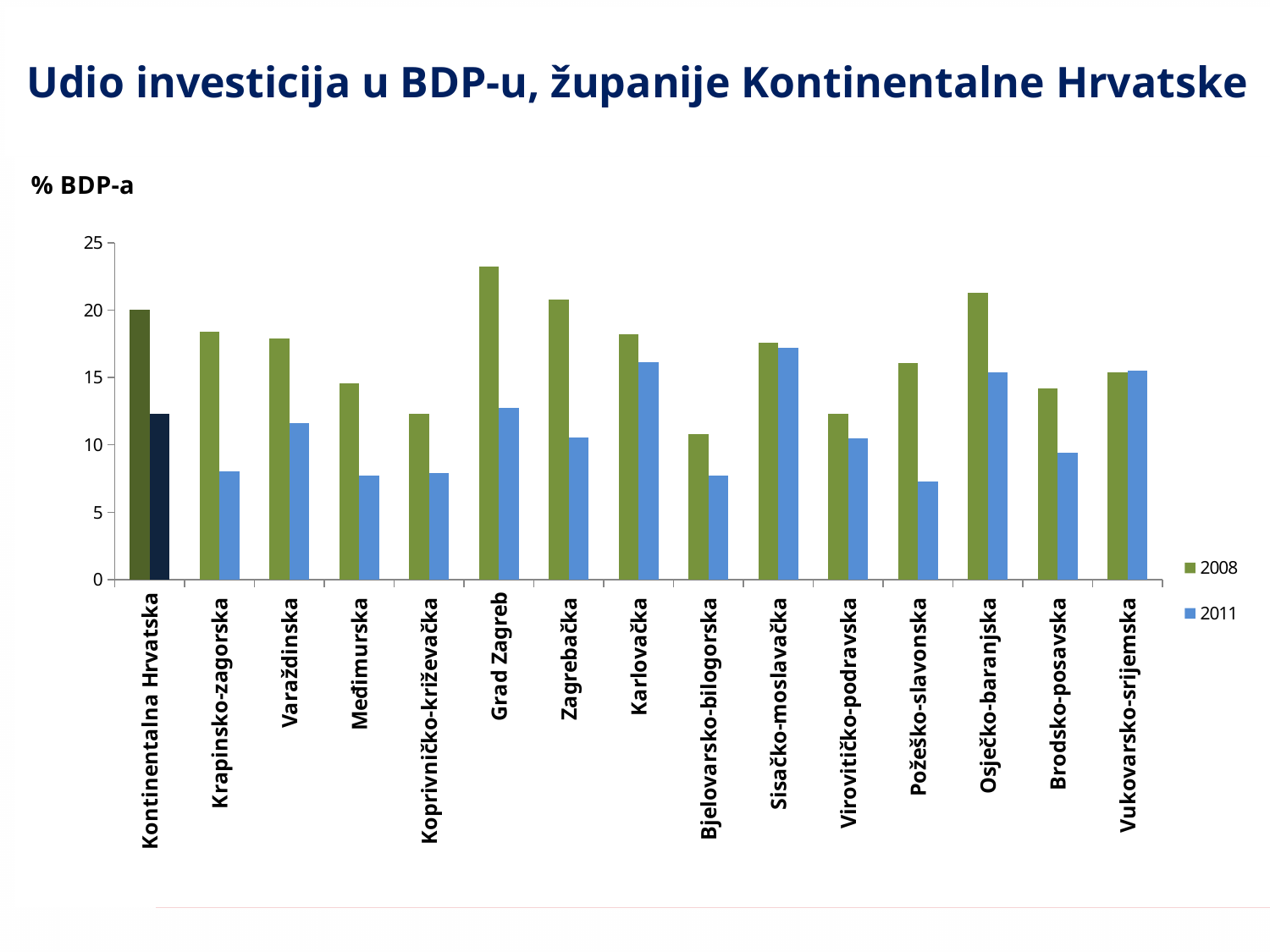
Which has the larger 2008 value: Grad Zagreb or Zagrebačka? Grad Zagreb Is the 2008 value for Osječko-baranjska greater or less than 20? greater Is the 2011 value for Krapinsko-zagorska greater or less than 10? less What is the title of the chart? Udio investicija u BDP-u, županije Kontinentalne Hrvatske Is the 2008 value for Grad Zagreb greater or less than 20? greater Which category has the highest value for 2011? Sisačko-moslavačka How many categories are shown on the x axis? 15 Which is larger for Karlovačka: the 2008 value or the 2011 value? 2008 How many series does the legend list? 2 Which category has the highest value for 2008? Grad Zagreb Which category has the lowest value for 2008? Bjelovarsko-bilogorska What kind of chart is shown on the slide? bar chart